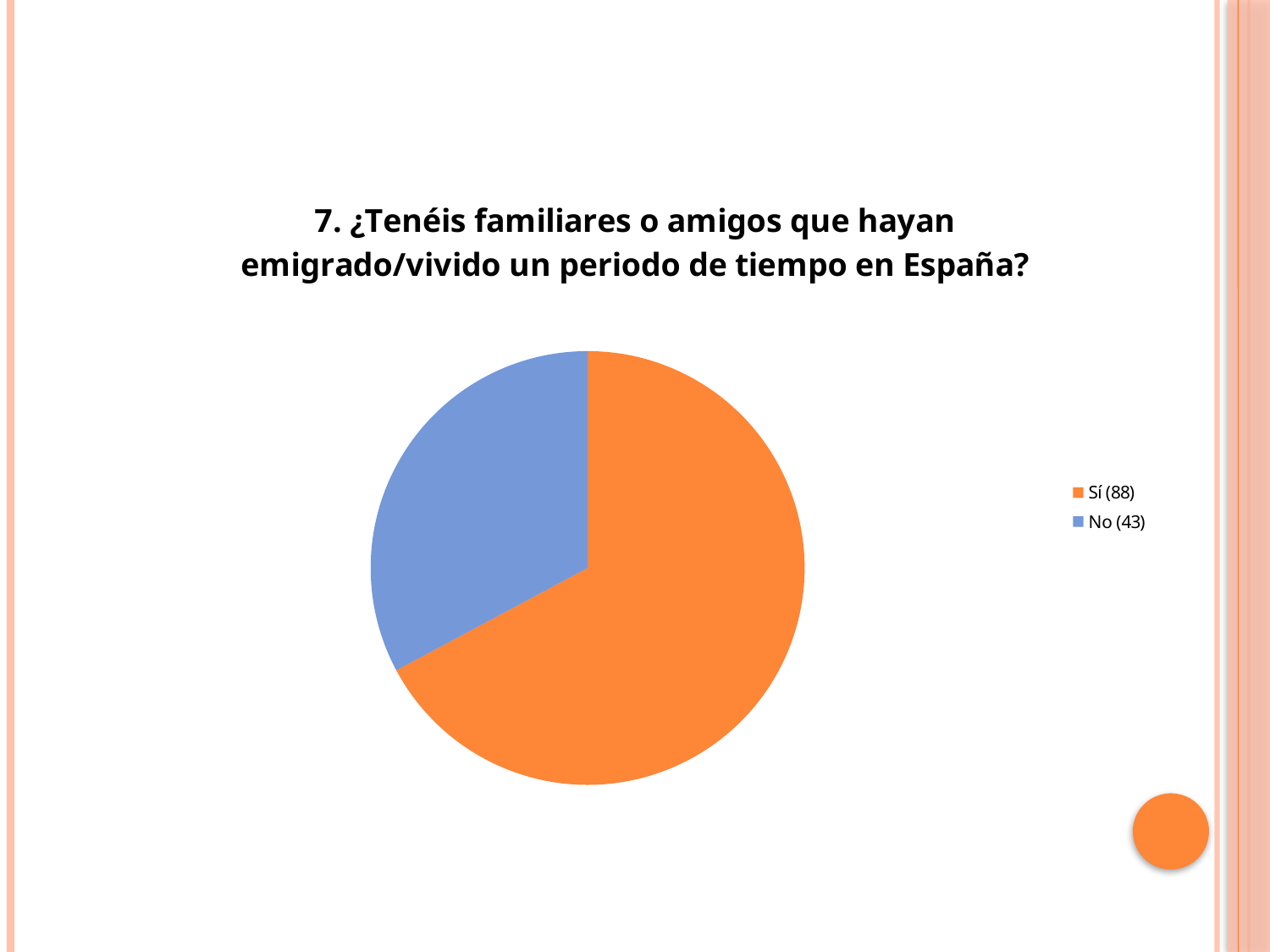
Which is larger, the value for "Sí" or the value for "No"? Sí Which category has the largest slice of the pie? Sí What is the title of the chart? 7. ¿Tenéis familiares o amigos que hayan emigrado/vivido un periodo de tiempo en España? Which category has the smallest slice of the pie? No What is the value for "Sí" in the pie chart? 88 What kind of chart is shown on the slide? Pie chart What is the total of the two values shown in the pie chart? 131 What is the difference between the value for "Sí" and the value for "No"? 45 How many slices does the pie chart have? 2 What is the value for "No" in the pie chart? 43 How many entries does the legend list? 2 What colour is the "Sí" slice in the pie chart? Orange